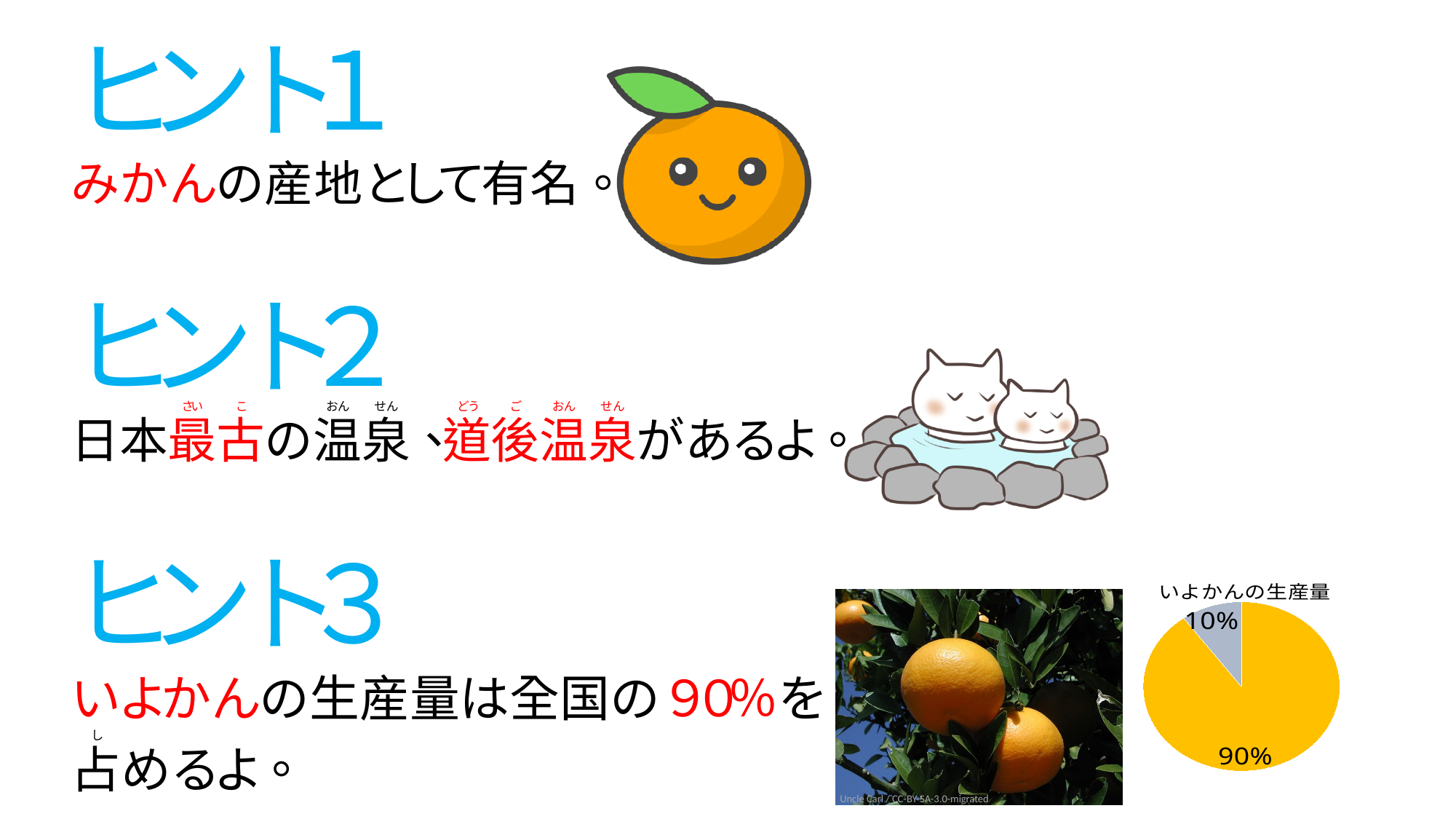
Do the two slices of the pie chart add up to 100%? yes What is the title of the pie chart? いよかんの生産量 How many slices does the pie chart have? 2 What share of the pie does the smallest slice represent? 10% Which slice is larger, the yellow slice or the grey slice? the yellow slice What colour is the largest slice of the pie chart? yellow What kind of chart is shown on the slide? pie chart What is the difference in percentage points between the two slices of the pie chart? 80 What share of the pie does the largest slice represent? 90% What is the value labelled on the yellow slice of the pie chart? 90% What is the value labelled on the grey slice of the pie chart? 10%